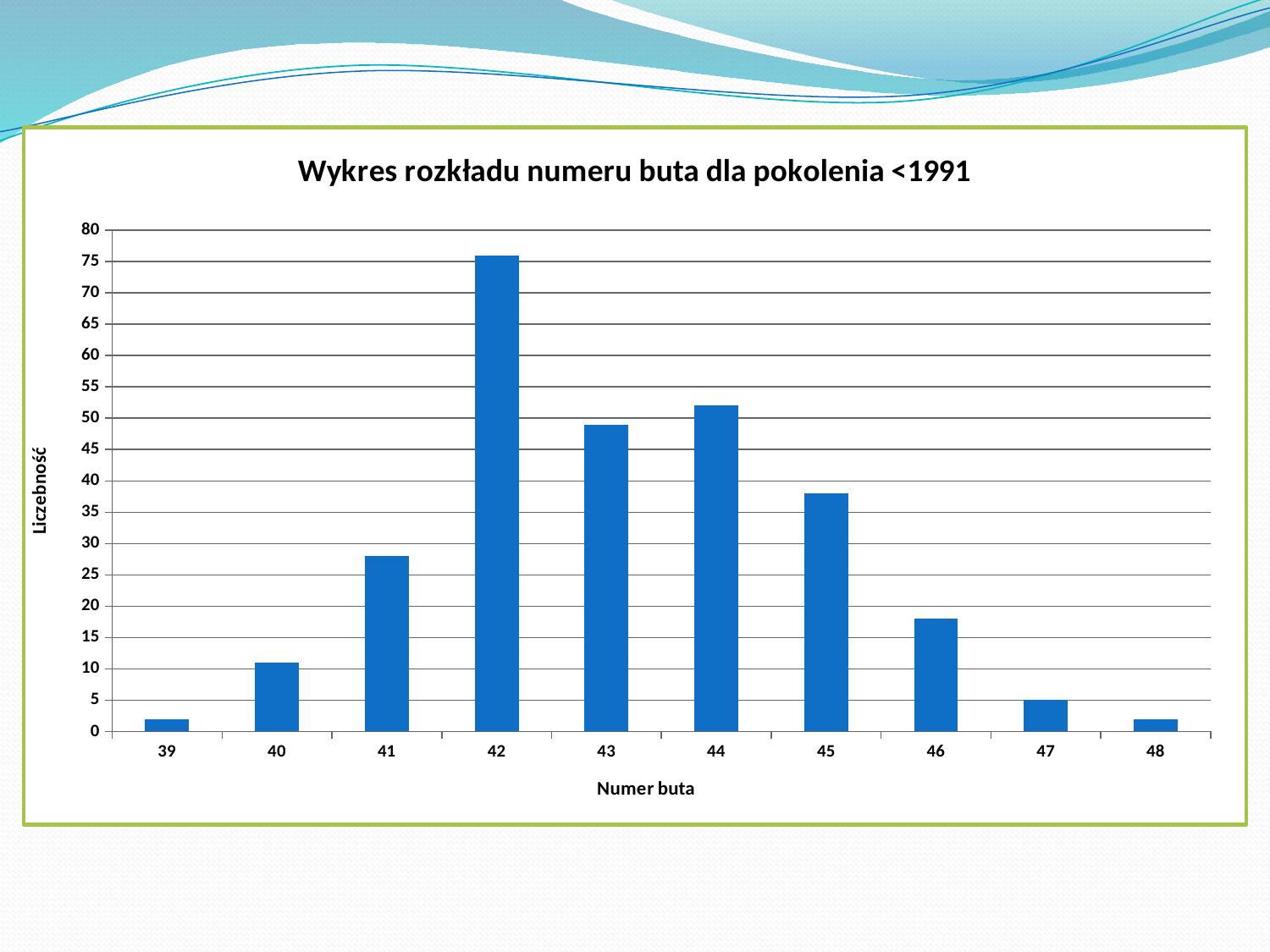
Is the value for shoe size 46 greater or less than 20? less What kind of chart is shown on the slide? bar chart Which shoe size has the highest count (Liczebność)? 42 What is the title of the chart? Wykres rozkładu numeru buta dla pokolenia <1991 How many shoe size categories are shown on the x axis? 10 Which has the larger count, shoe size 40 or shoe size 46? 46 Is the value for shoe size 42 greater or less than 70? greater Is the value for shoe size 41 greater or less than 25? greater What is the label of the x axis? Numer buta Which has the larger count, shoe size 41 or shoe size 45? 45